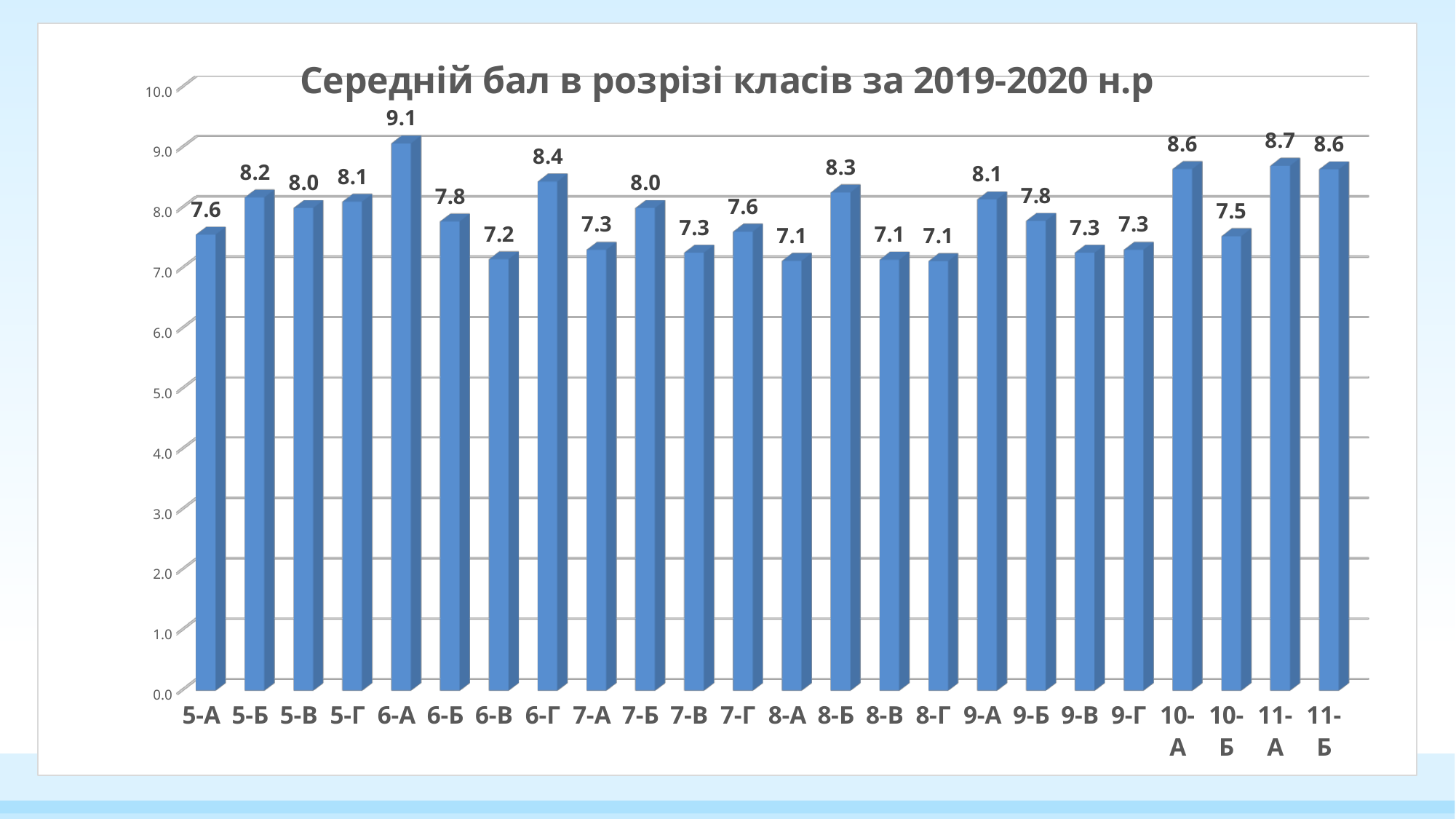
What is the difference between the values for 6-А and 6-В? 1.9 What is the title of the chart? Середній бал в розрізі класів за 2019-2020 н.р How many classes are shown on the chart? 24 Is the value for 11-А greater or less than 8.0? greater What is the value for 6-Г? 8.4 Which is larger, the value for 5-Б or the value for 9-Б? 5-Б What is the value for 10-Б? 7.5 What is the value for 8-Б? 8.3 What is the difference between the values for 11-А and 10-Б? 1.2 Which class has the highest average score? 6-А What kind of chart is shown on the slide? bar chart What is the lowest value shown on the chart? 7.1